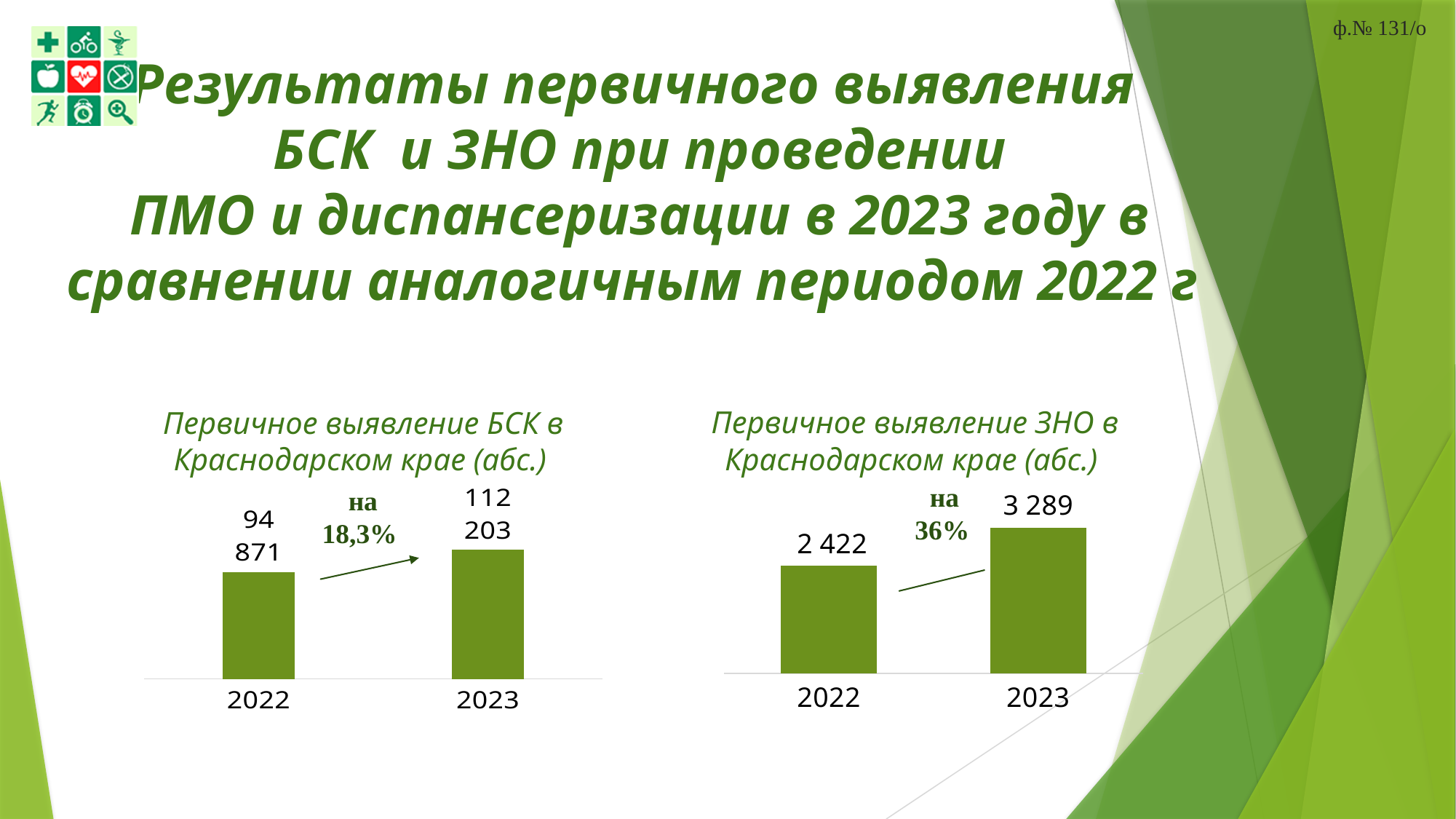
In the right chart (Первичное выявление ЗНО), which year has the lower value? 2022 In the right chart (Первичное выявление ЗНО в Краснодарском крае), what is the value for 2023? 3 289 In the right chart (Первичное выявление ЗНО), is the value for 2023 larger or smaller than the value for 2022? larger In the left chart (Первичное выявление БСК в Краснодарском крае), what is the value for 2022? 94 871 How many bars are shown in the left chart (Первичное выявление БСК)? 2 In the left chart (Первичное выявление БСК в Краснодарском крае), what is the value for 2023? 112 203 In the right chart (Первичное выявление ЗНО), what is the difference between the 2023 and 2022 values? 867 What type of chart is used for Первичное выявление ЗНО в Краснодарском крае? bar chart In the right chart (Первичное выявление ЗНО), what percentage increase from 2022 to 2023 is annotated on the chart? на 36% In the left chart (Первичное выявление БСК), by how much does the 2023 value exceed the 2022 value? 17 332 In the left chart (Первичное выявление БСК), which year has the higher value? 2023 In the right chart (Первичное выявление ЗНО в Краснодарском крае), what is the value for 2022? 2 422